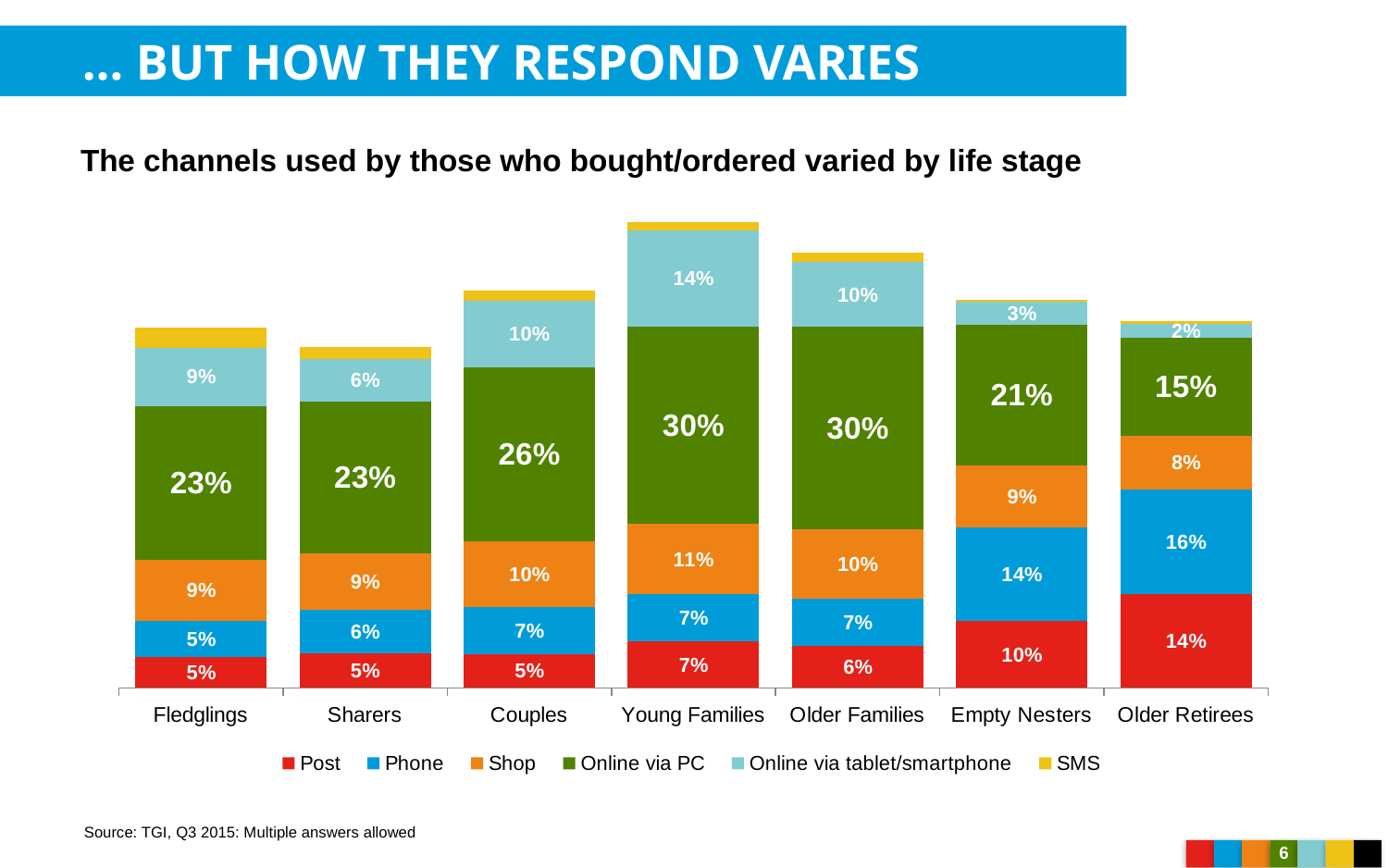
What percentage of Empty Nesters used Online via PC? 21% Which is larger: the Phone percentage for Empty Nesters or for Fledglings? Empty Nesters How many series does the legend list? 6 What percentage of Couples used Shop? 10% What percentage of Older Retirees used Phone? 16% Which life stage has the highest percentage for Online via tablet/smartphone? Young Families What is the difference between the Online via PC percentage for Young Families and for Older Retirees? 15% What kind of chart is shown on the slide? Stacked bar chart Which life stage has the highest percentage for Post? Older Retirees How many life stage categories are shown on the x axis? 7 What percentage of Young Families used Online via tablet/smartphone? 14% Which life stage has the lowest percentage for Online via tablet/smartphone? Older Retirees